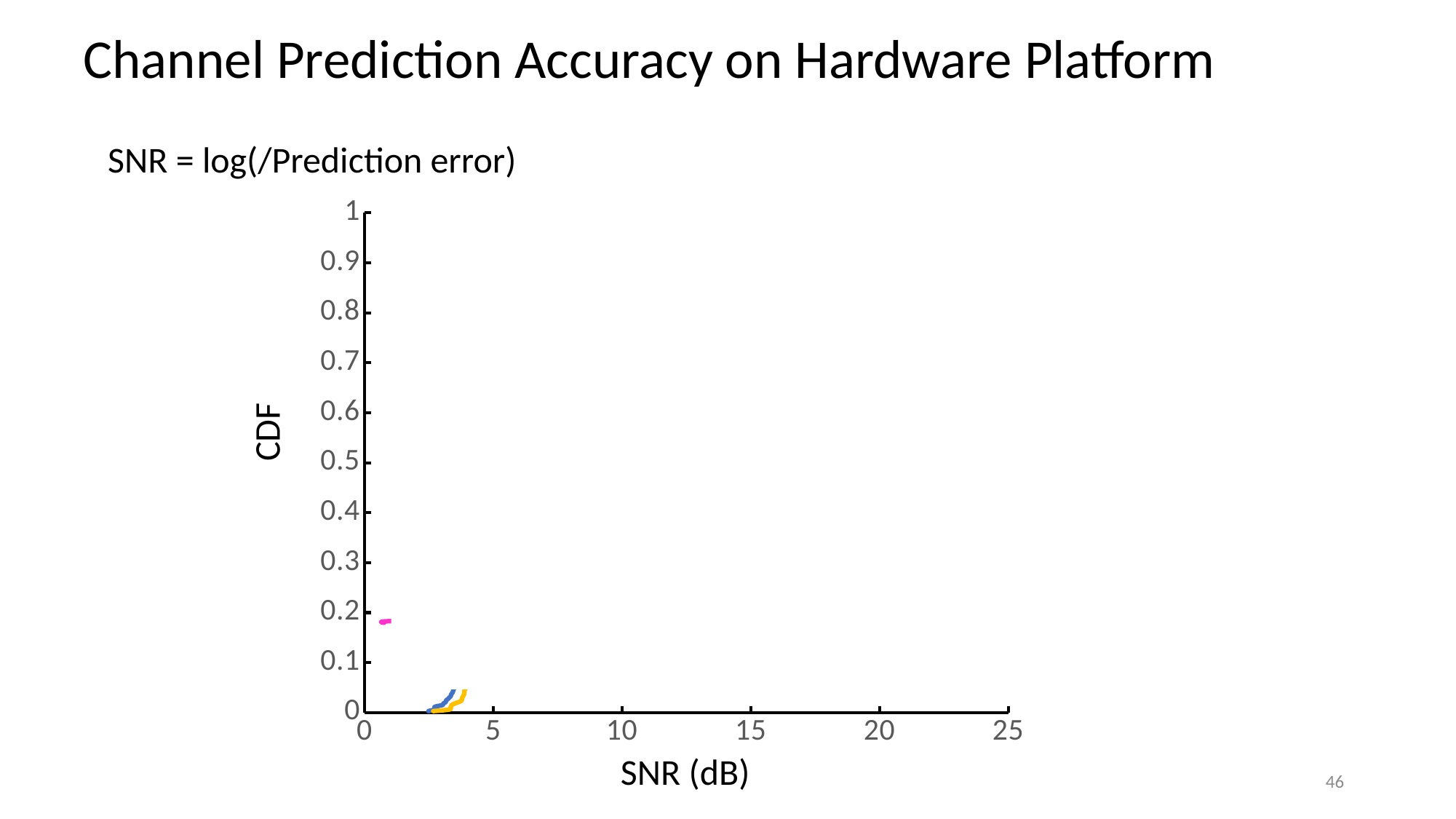
Which line is plotted at a higher SNR, the yellow line or the pink line? yellow line What is the label of the x axis of the chart? SNR (dB) Which line reaches a higher CDF value, the pink line or the blue line? pink line What kind of chart is shown on the slide? line chart What is the title of the slide containing the chart? Channel Prediction Accuracy on Hardware Platform How many differently coloured lines are plotted on the chart? 3 Is the CDF value reached by the pink line greater or less than 0.3? less Is the CDF value reached by the blue line greater or less than 0.1? less Is the SNR at which the yellow line is plotted greater or less than 5? less